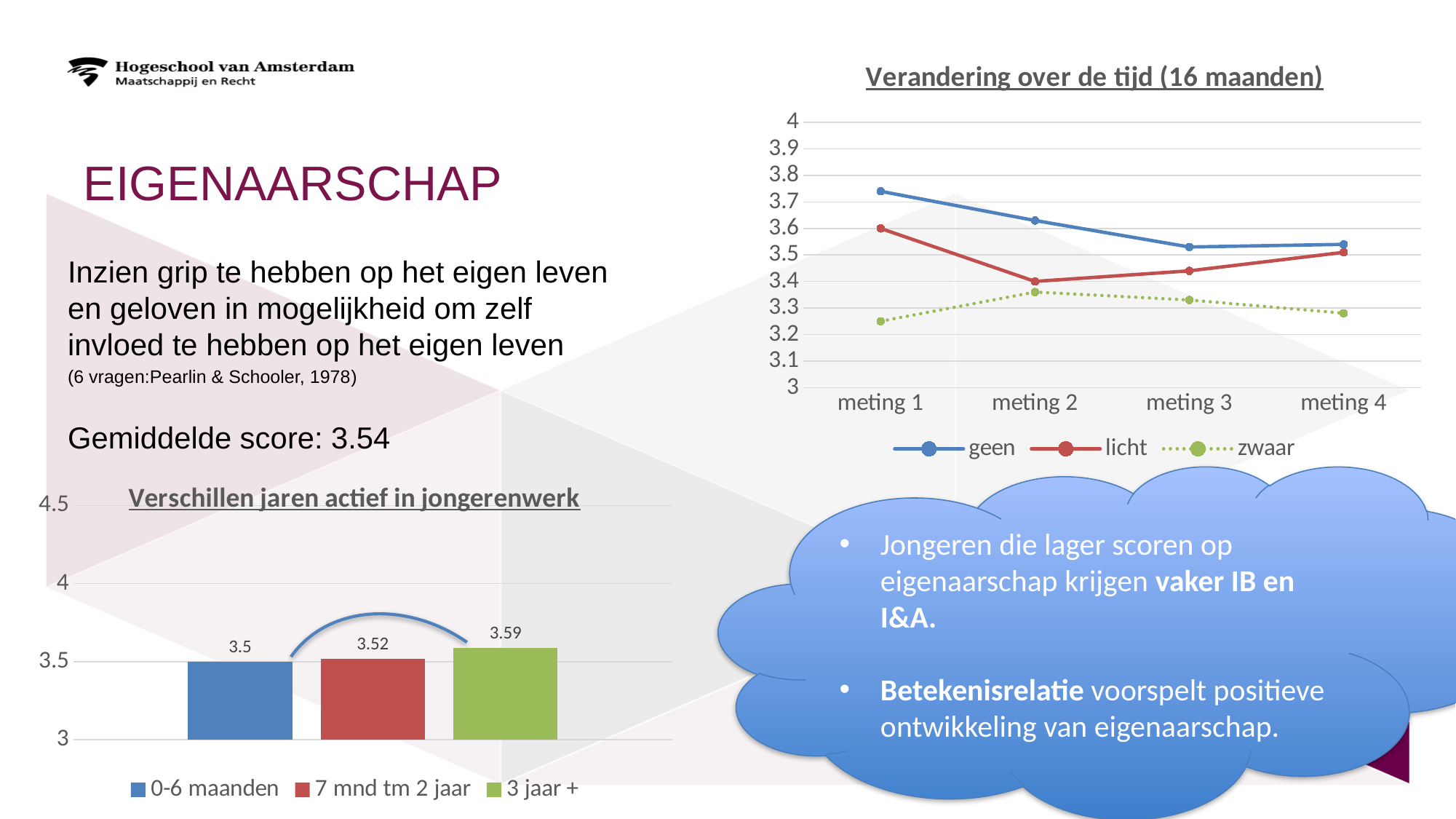
In the line chart 'Verandering over de tijd (16 maanden)', which series has the highest value at meting 1? geen In the line chart 'Verandering over de tijd (16 maanden)', how many series does the legend list? 3 In the bar chart 'Verschillen jaren actief in jongerenwerk', what is the value for '3 jaar +'? 3.59 In the bar chart 'Verschillen jaren actief in jongerenwerk', how many categories are shown? 3 In the bar chart 'Verschillen jaren actief in jongerenwerk', which category has the highest value? 3 jaar + What kind of chart is 'Verschillen jaren actief in jongerenwerk'? bar chart In the bar chart 'Verschillen jaren actief in jongerenwerk', what is the value for '0-6 maanden'? 3.5 In the bar chart 'Verschillen jaren actief in jongerenwerk', what is the difference between the values for '3 jaar +' and '0-6 maanden'? 0.09 In the line chart 'Verandering over de tijd (16 maanden)', does the 'geen' series rise or fall from meting 1 to meting 3? fall In the line chart 'Verandering over de tijd (16 maanden)', is the value for 'geen' at meting 1 greater or less than 3.7? greater In the bar chart 'Verschillen jaren actief in jongerenwerk', which category has the lowest value? 0-6 maanden